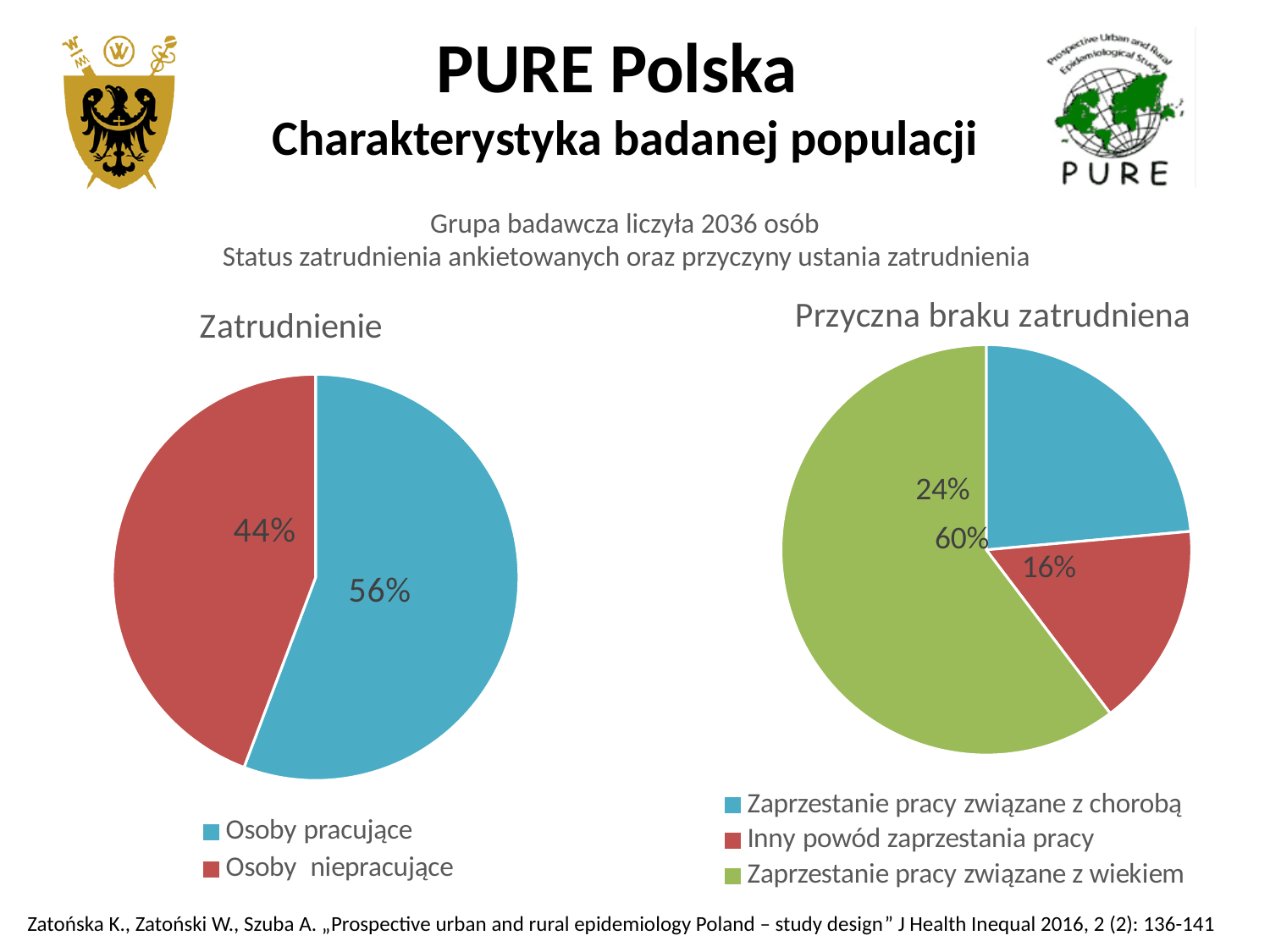
In the "Przyczna braku zatrudniena" chart, which category has the smallest share? Inny powód zaprzestania pracy In the "Przyczna braku zatrudniena" chart, what is the difference between the shares of "Zaprzestanie pracy związane z chorobą" and "Inny powód zaprzestania pracy"? 8% In the "Zatrudnienie" chart, how many categories does the legend list? 2 In the "Zatrudnienie" chart, what share of the pie is "Osoby niepracujące"? 44% In the "Przyczna braku zatrudniena" chart, which category has the largest share? Zaprzestanie pracy związane z wiekiem In the "Przyczna braku zatrudniena" chart, what share is "Inny powód zaprzestania pracy"? 16% In the "Przyczna braku zatrudniena" chart, what share is "Zaprzestanie pracy związane z wiekiem"? 60% In the "Zatrudnienie" chart, what is the difference between the shares of "Osoby pracujące" and "Osoby niepracujące"? 12% In the "Zatrudnienie" chart, which category has the larger share? Osoby pracujące What type of chart is the "Przyczna braku zatrudniena" chart? Pie chart